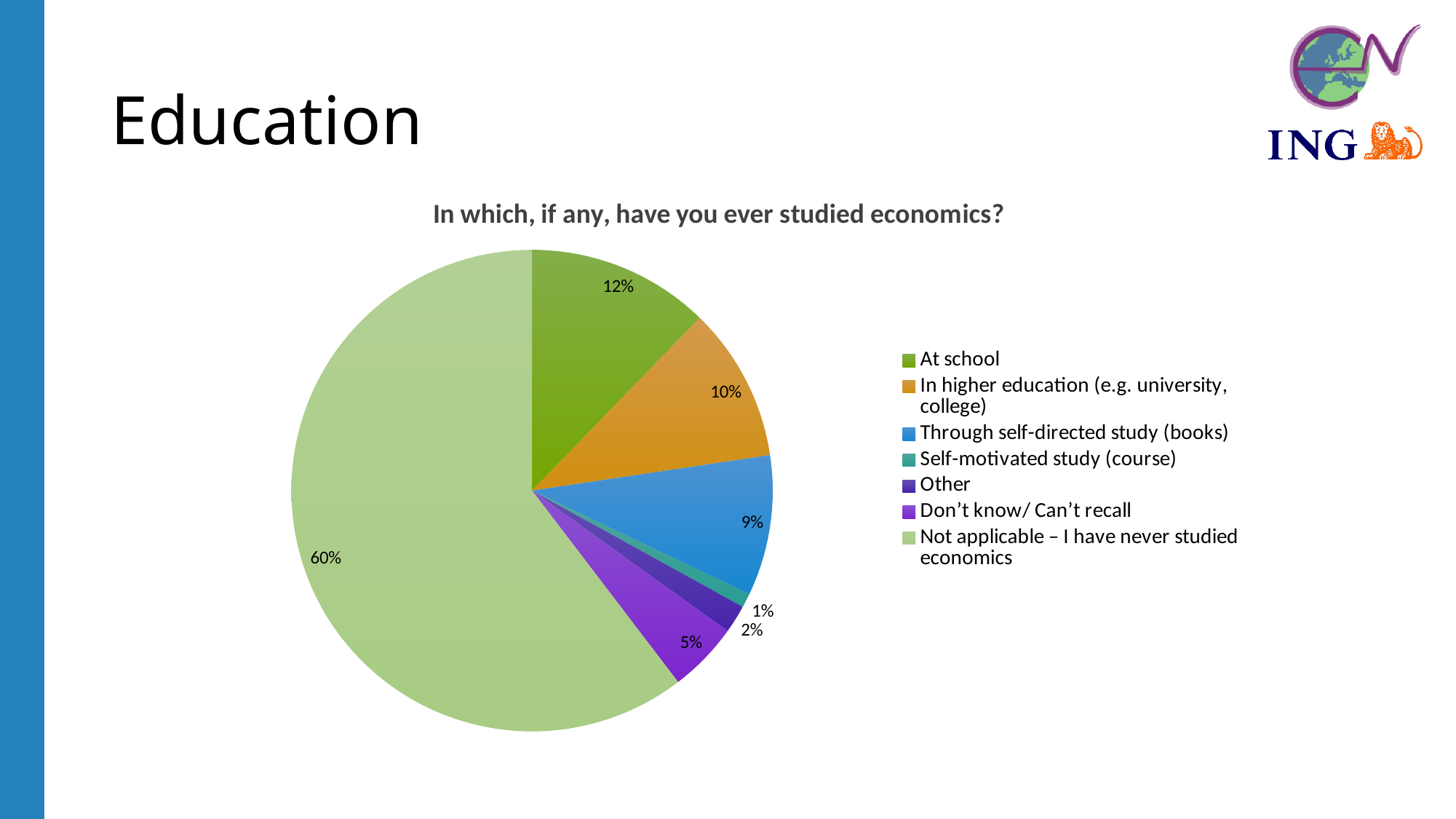
What percentage of respondents studied economics through self-directed study (books)? 9% What is the difference in percentage points between 'At school' and 'In higher education (e.g. university, college)'? 2 How many categories does the legend list? 7 What percentage of respondents studied economics in higher education (e.g. university, college)? 10% What percentage of respondents studied economics at school? 12% Which category has the smallest slice of the pie? Self-motivated study (course) What percentage of respondents answered 'Don't know/ Can't recall'? 5% Which category has the largest slice of the pie? Not applicable – I have never studied economics What share of respondents answered 'Not applicable – I have never studied economics'? 60% What type of chart is shown on the slide? Pie chart What is the title of the chart? In which, if any, have you ever studied economics? Which is larger: the share for 'Through self-directed study (books)' or the share for 'Don't know/ Can't recall'? Through self-directed study (books)